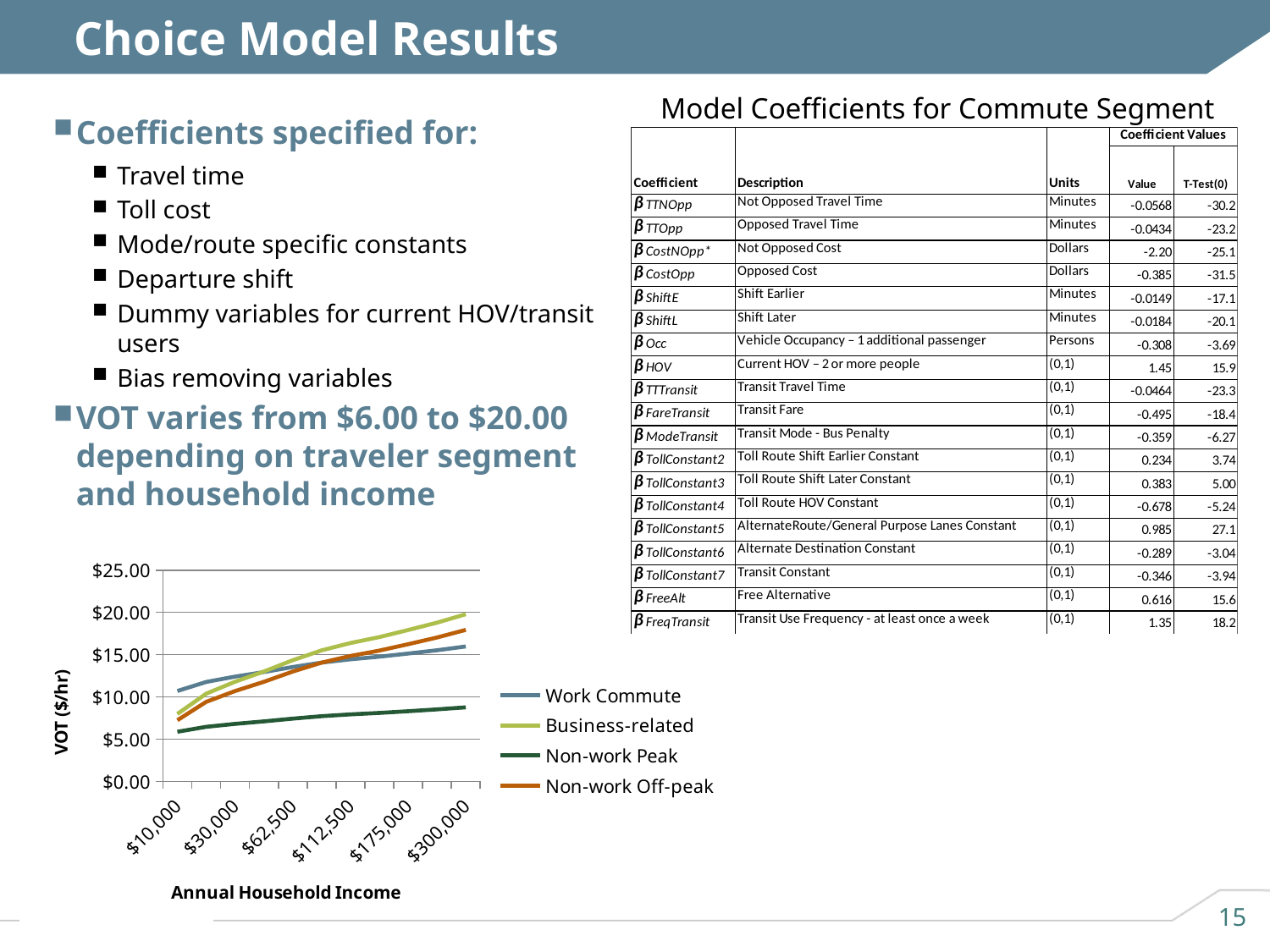
How many income levels are labeled on the x axis of the chart? 6 How many series does the chart legend list? 4 Is the VOT for Business-related at $300,000 greater or less than $15.00? greater At $300,000 annual household income, which is larger: the VOT for Business-related or for Non-work Peak? Business-related Does the VOT for Work Commute rise or fall as annual household income increases? rise Which series has the lowest VOT at $300,000 annual household income? Non-work Peak Is the VOT for Work Commute at $10,000 greater or less than $5.00? greater What is the title of the chart's y axis? VOT ($/hr) Which series has the highest VOT at $10,000 annual household income? Work Commute What kind of chart is shown on the slide? line chart Which series has the highest VOT at $300,000 annual household income? Business-related Is the VOT for Non-work Peak at $300,000 greater or less than $10.00? less